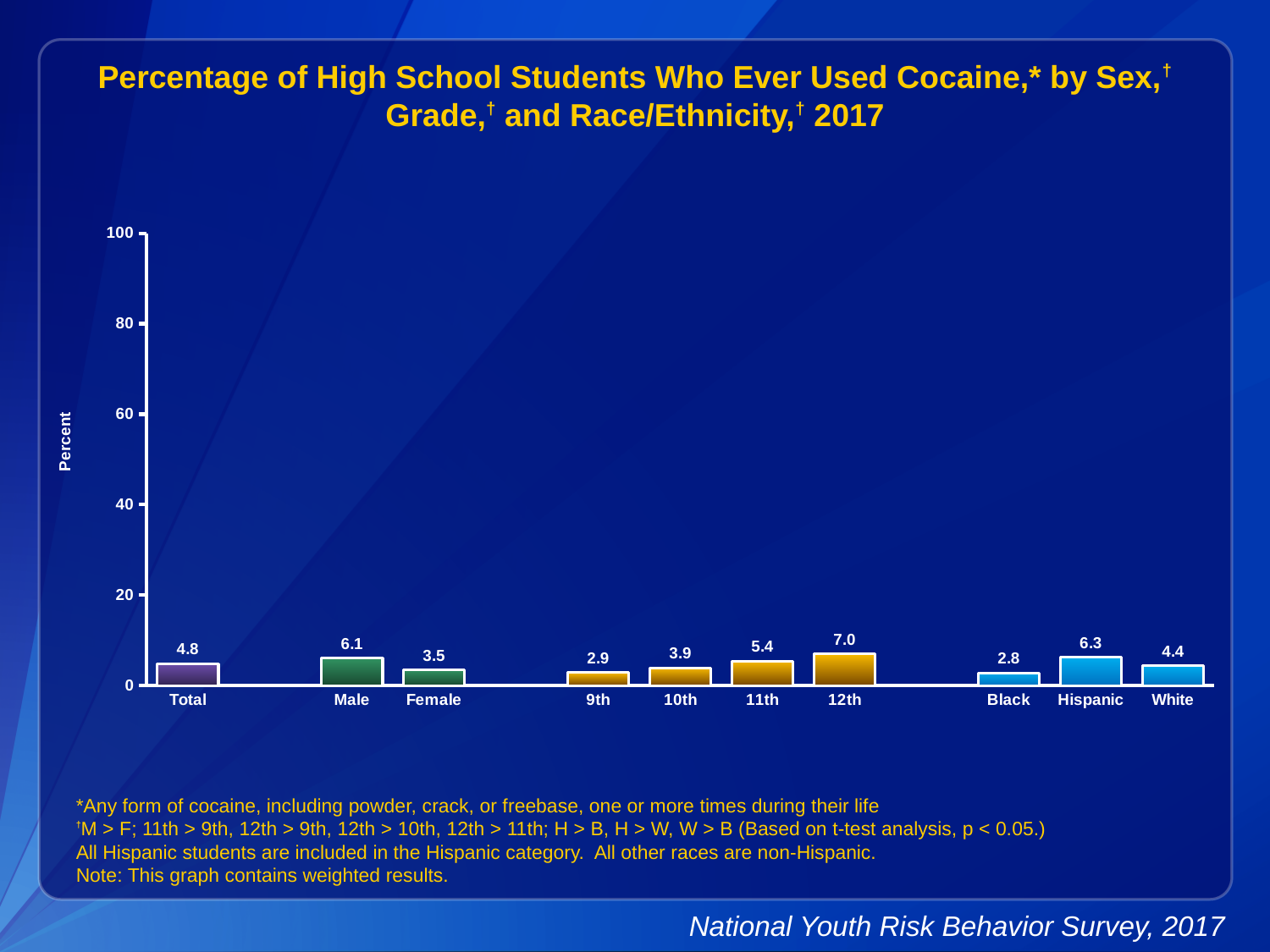
Which category has the lowest value? Black What is the value for Total? 4.8 What kind of chart is shown on the slide? bar chart Is the value for 11th grade greater or less than 20? less Which is larger, the value for Hispanic or the value for White? Hispanic What is the value for Male? 6.1 Which category has the highest value? 12th What is the value for 12th grade? 7.0 What is the value for Hispanic? 6.3 How many categories are shown on the x axis? 10 What is the difference between the Male and Female values? 2.6 Do the values rise or fall from 9th grade to 12th grade? rise